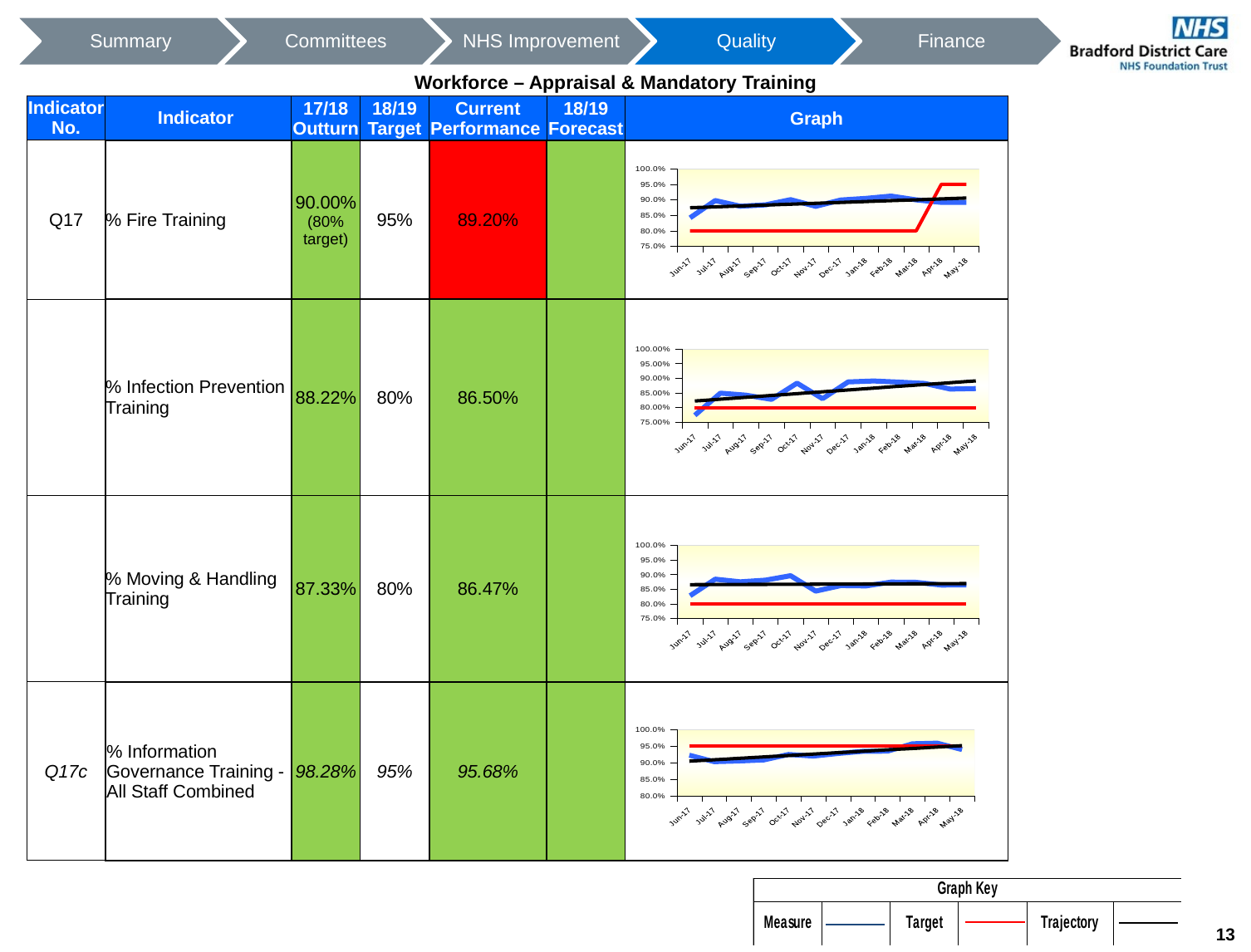
In the % Information Governance Training chart, is the blue Measure value for Jun-17 greater or less than 95.0%? less In the % Information Governance Training chart, what value is the red Target line at? 95.0% How many months are plotted along the x axis of the % Infection Prevention Training chart? 12 In the % Fire Training chart, what value does the red Target line reach in May-18? 95.0% In the % Information Governance Training chart, does the blue Measure line generally rise or fall from Jun-17 to May-18? Rise In the % Infection Prevention Training chart, what value is the red Target line at throughout the period? 80.00% In the % Fire Training chart, what value does the red Target line sit at in Jun-17? 80.0% According to the Graph Key, which colour line represents the Target? Red In the % Moving & Handling Training chart, is the blue Measure value for Oct-17 greater or less than 85.0%? greater What kind of chart is shown in the Graph column for % Fire Training? Line chart How many series does the Graph Key list for the charts? 3 In the % Infection Prevention Training chart, is the blue Measure value for May-18 greater or less than 85.00%? greater